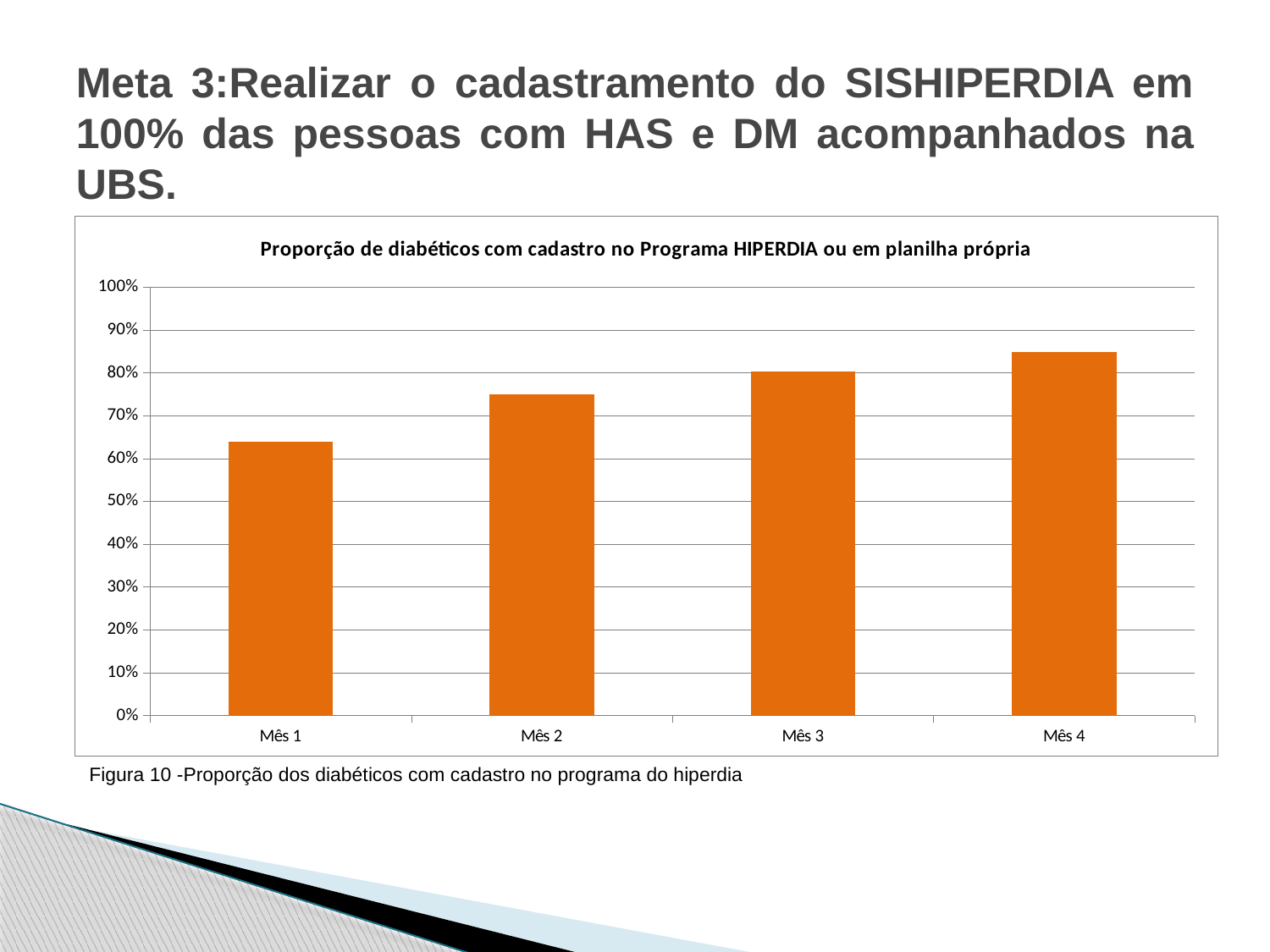
Is the value for Mês 1 greater or less than 70%? less Is the value for Mês 4 greater or less than 90%? less Do the values rise or fall from Mês 1 to Mês 4? rise Is the value for Mês 4 greater or less than 80%? greater How many categories (months) are plotted on the x axis? 4 What is the title of the chart? Proporção de diabéticos com cadastro no Programa HIPERDIA ou em planilha própria Which month has the lowest proportion of diabetics registered? Mês 1 Which is larger, the value for Mês 2 or the value for Mês 3? Mês 3 What kind of chart is shown on the slide? bar chart Which month has the highest proportion of diabetics registered? Mês 4